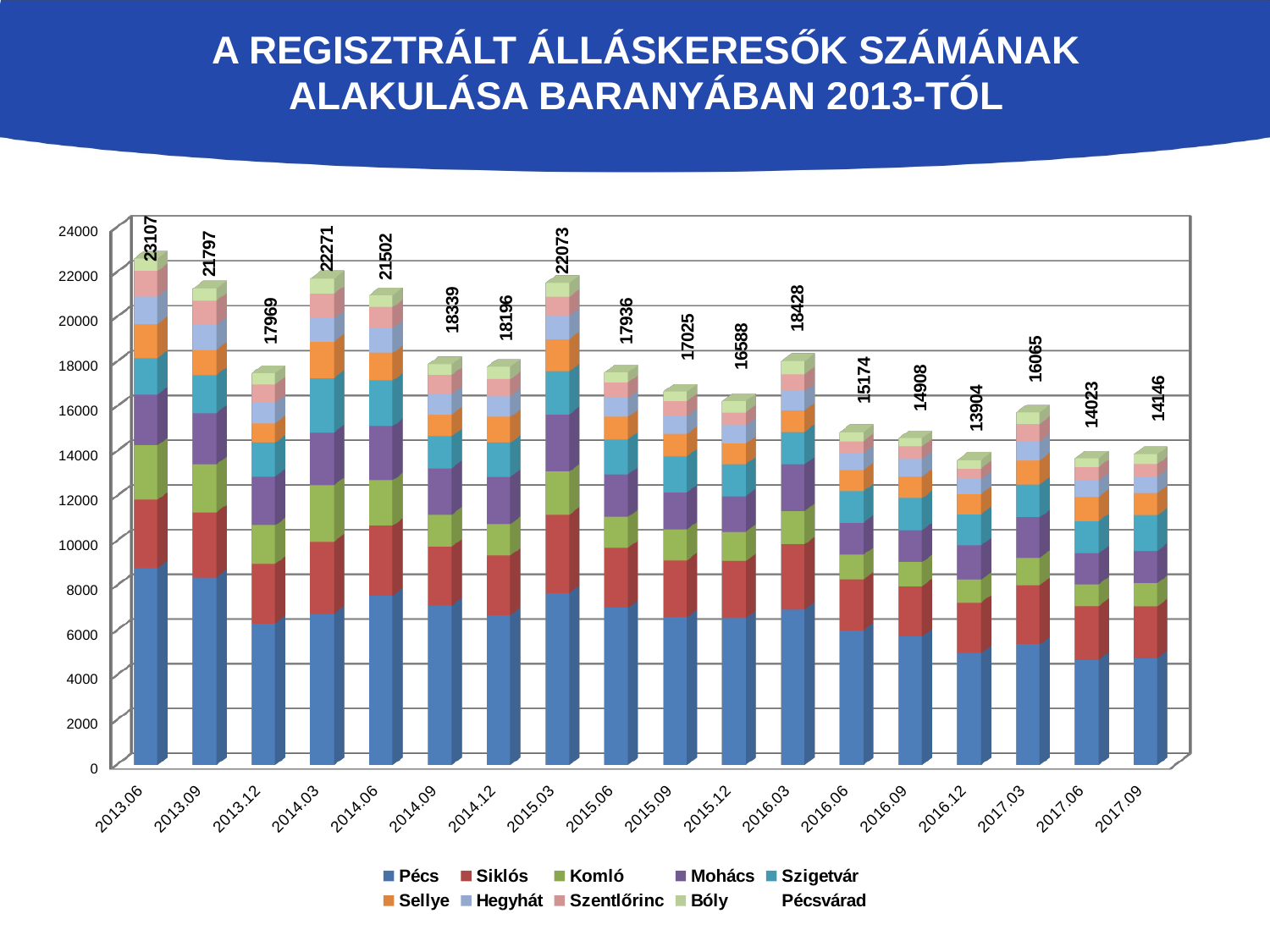
Which period has a larger total, 2015.03 or 2016.03? 2015.03 What is the total value labelled for 2017.03? 16065 What kind of chart is shown on the slide? Stacked bar chart Which period has the highest total number of registered jobseekers? 2013.06 What is the difference between the totals for 2014.03 and 2014.06? 769 How many series does the legend list? 10 What is the total number of registered jobseekers shown for 2013.06? 23107 Which period has the lowest total number of registered jobseekers? 2016.12 What is the difference between the total for 2013.06 and the total for 2016.12? 9203 What is the total value labelled above the bar for 2016.12? 13904 How many periods (bars) are shown on the x axis? 18 Is the Pécs value for 2017.09 greater or less than 6000? less